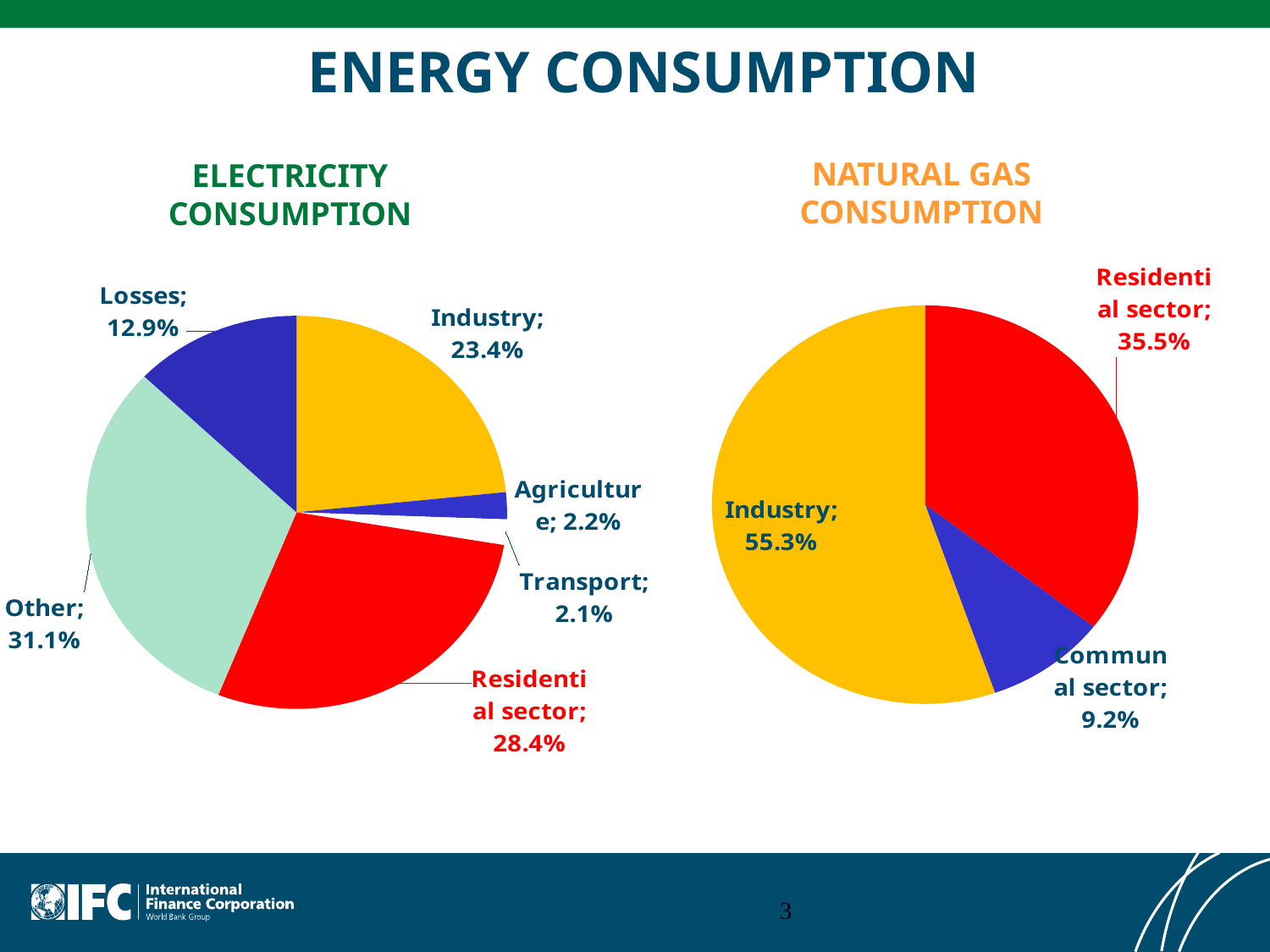
In the Electricity Consumption chart, what share does Transport have? 2.1% In the Electricity Consumption chart, what share does Industry have? 23.4% In the Electricity Consumption chart, which is larger: Losses or Industry? Industry In the Natural Gas Consumption chart, what share does the Residential sector have? 35.5% How many categories are shown in the Electricity Consumption chart? 6 In the Electricity Consumption chart, which category has the largest share? Other What type of chart is the Natural Gas Consumption chart? Pie chart In the Electricity Consumption chart, what is the difference between the Other share and the Residential sector share? 2.7% How many categories are shown in the Natural Gas Consumption chart? 3 In the Natural Gas Consumption chart, what is the difference between the Industry share and the Residential sector share? 19.8% In the Natural Gas Consumption chart, which category has the smallest share? Communal sector What is the title of the slide? ENERGY CONSUMPTION